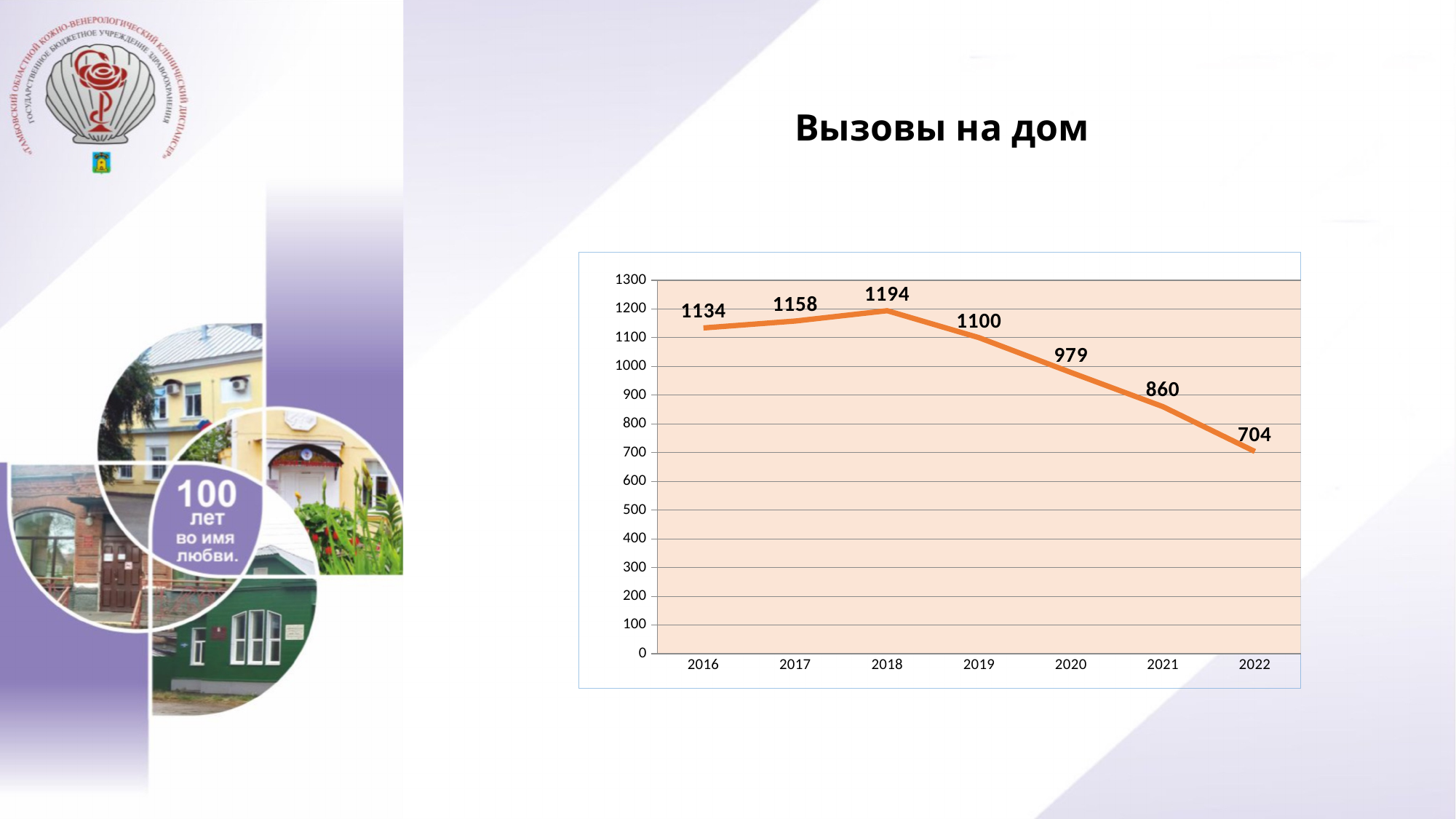
What is the value for 2016? 1134 What is the difference between the values for 2018 and 2022? 490 Which year has the lowest value? 2022 Is the value for 2021 greater or less than 900? less What kind of chart is shown on the slide? line chart What is the value for 2022? 704 How many years are plotted on the chart? 7 What is the difference between the values for 2020 and 2021? 119 Which year has the highest value? 2018 Which is larger, the value for 2017 or the value for 2020? 2017 What is the value for 2019? 1100 What is the title of the chart? Вызовы на дом